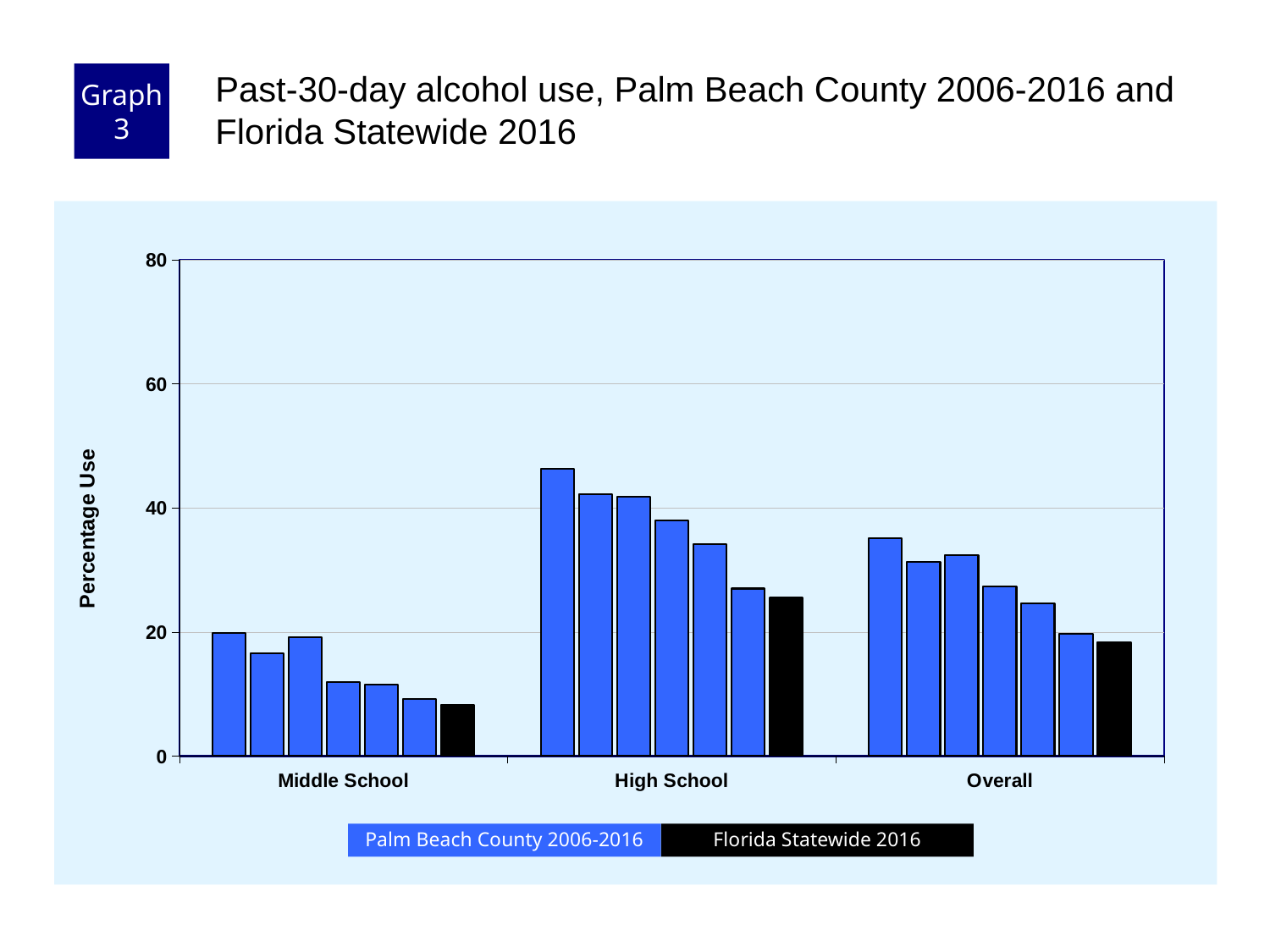
What is the label on the y axis? Percentage Use How many series does the legend list? 2 Is the Florida Statewide 2016 value for Middle School greater or less than 20? less Do the Palm Beach County 2006-2016 bars for High School rise or fall from left to right? Fall Is the Florida Statewide 2016 value for High School greater or less than 20? greater Which category has the highest Florida Statewide 2016 value? High School Which is larger: the Florida Statewide 2016 value for High School or for Overall? High School What kind of chart is shown on the slide? Bar chart Is the tallest Palm Beach County bar for High School greater or less than 40? greater Which series is shown in black? Florida Statewide 2016 Which category has the lowest Florida Statewide 2016 value? Middle School How many categories are shown on the x axis? 3